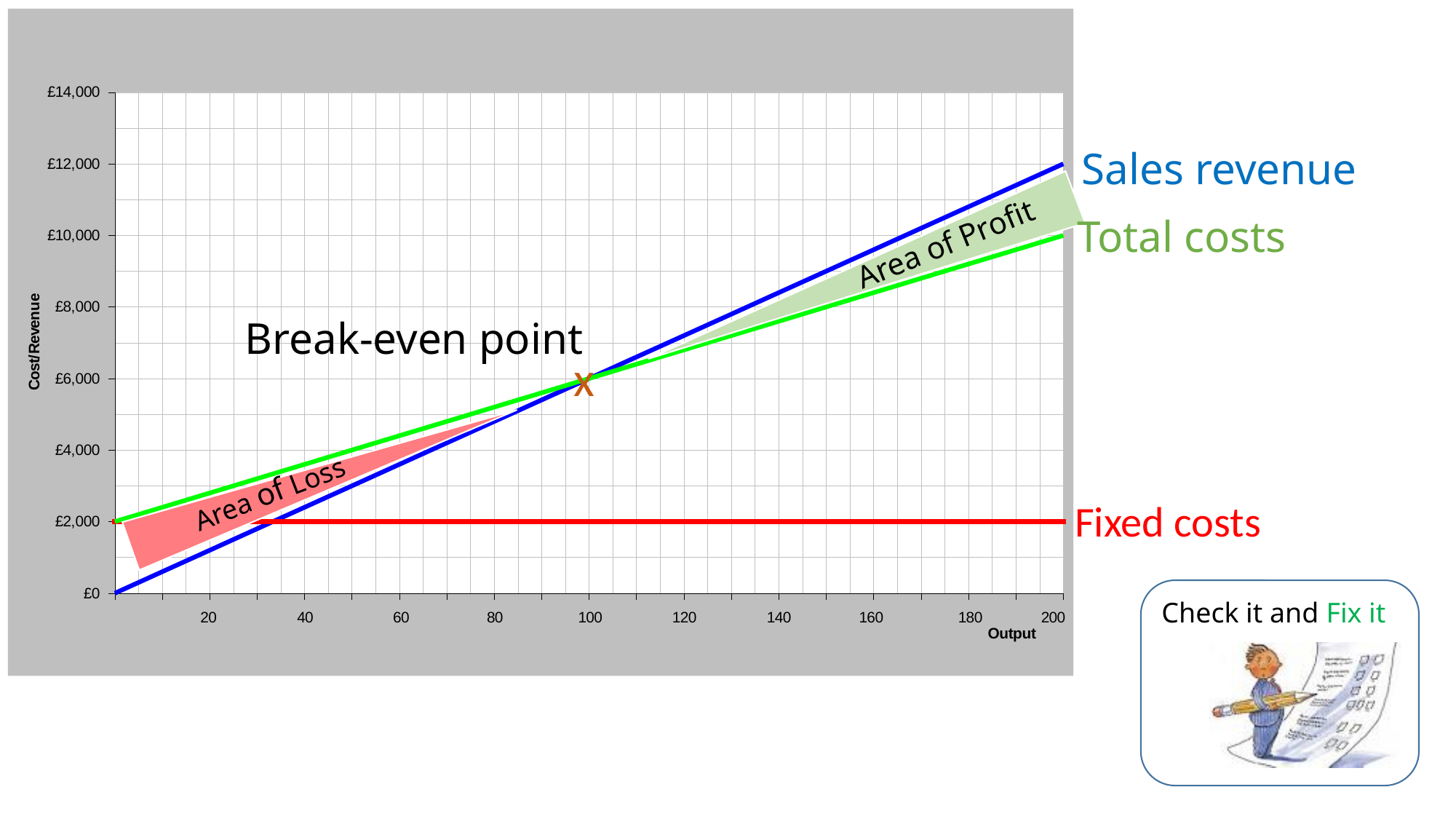
What is the cost/revenue value at the break-even point? £6,000 What kind of chart is shown on the slide? line chart At an output of 40, which is higher: Sales revenue or Total costs? Total costs What are the Total costs at an output of 0? £2,000 What are the Total costs at an output of 200? £10,000 What is the Sales revenue at an output of 200? £12,000 Does the Sales revenue line rise or fall as output increases? rises What is the title of the x axis? Output How many lines (series) are plotted on the chart? 3 What is the value of the Fixed costs line? £2,000 At an output of 200, what is the difference between Sales revenue and Total costs? £2,000 At what output level is the break-even point? 100